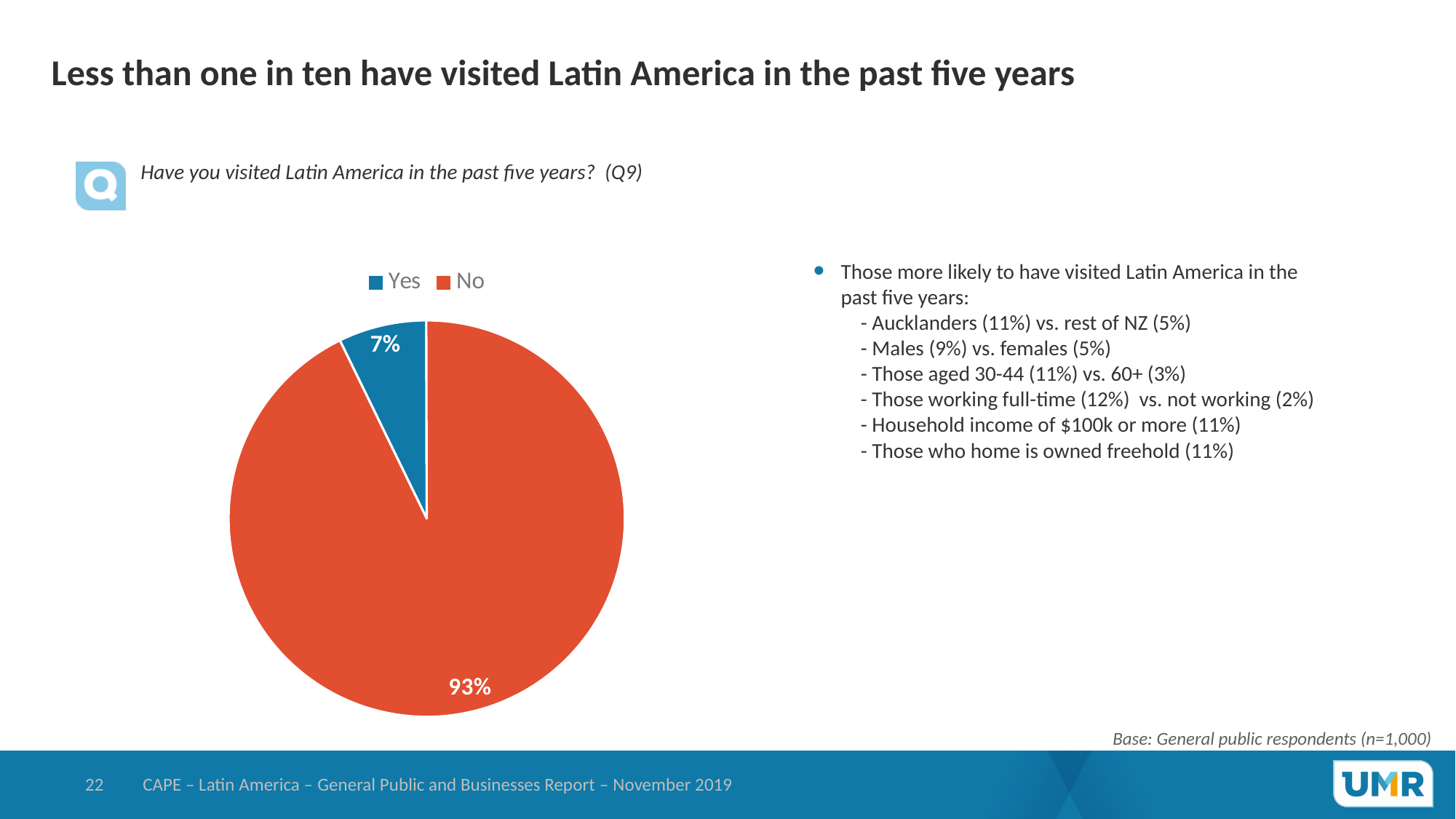
How many entries does the legend list? 2 What survey question does the pie chart show responses to? Have you visited Latin America in the past five years? (Q9) Which response has the smallest share of the pie? Yes How many slices does the pie chart have? 2 What share of the pie does the "No" slice represent? 93% What percentage of respondents answered "No"? 93% What is the difference in percentage points between the "No" and "Yes" slices? 86 Which response has the largest share of the pie? No What kind of chart is shown on the slide? Pie chart What percentage of respondents answered "Yes" to having visited Latin America in the past five years? 7% What colour is the "Yes" slice in the pie chart? Blue Which is larger, the "Yes" slice or the "No" slice? No